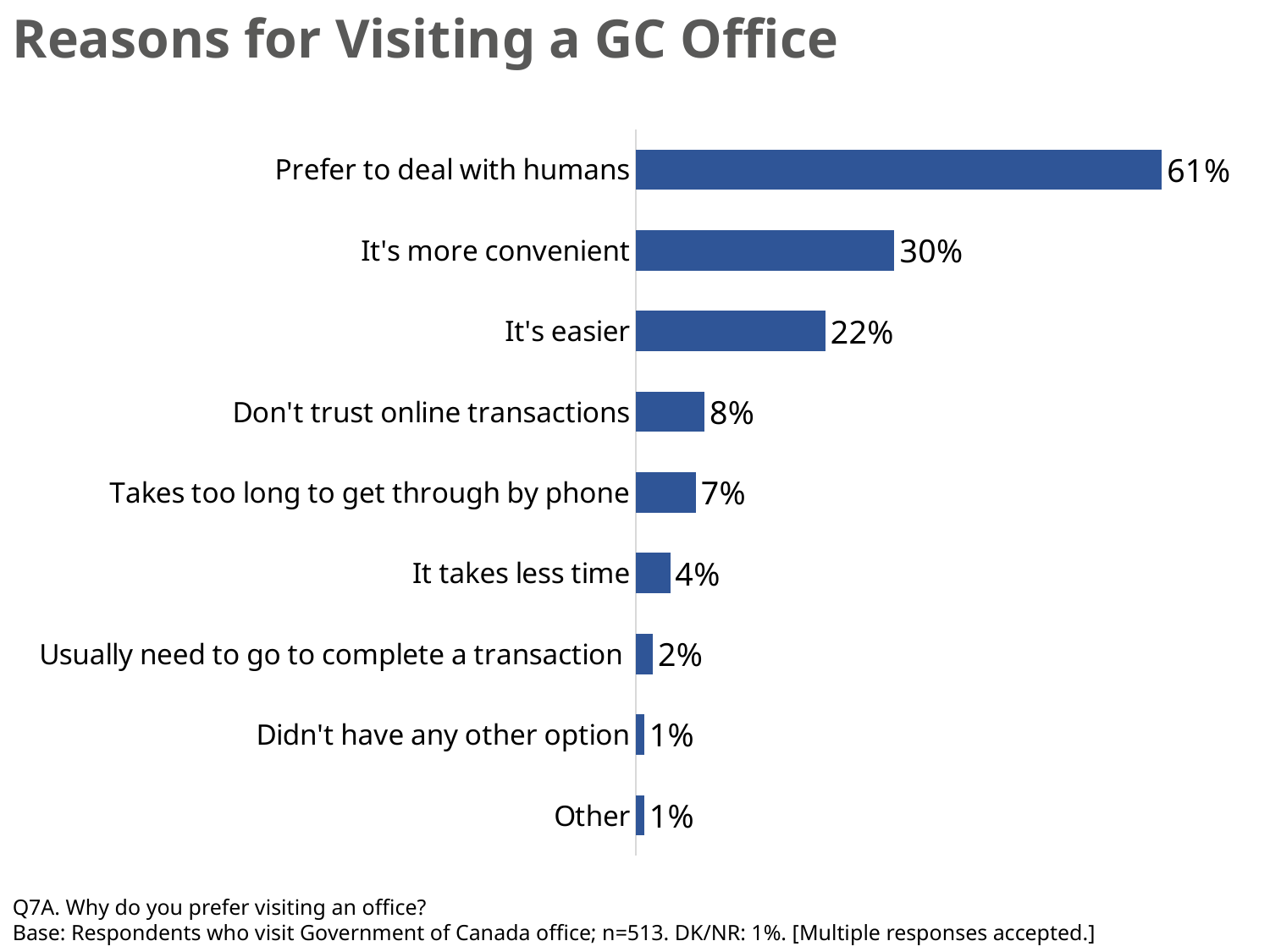
Which reason has the highest percentage? Prefer to deal with humans What is the value for "Usually need to go to complete a transaction"? 2% What kind of chart is shown on the slide? Bar chart What percentage of respondents said "Don't trust online transactions"? 8% Which is larger: "Don't trust online transactions" or "Takes too long to get through by phone"? Don't trust online transactions What is the value for "It's more convenient"? 30% What percentage of respondents said they prefer to deal with humans? 61% What is the difference between "It's more convenient" and "It's easier"? 8% What is the difference between "Prefer to deal with humans" and "It's more convenient"? 31% What is the value for "It takes less time"? 4% What is the title of the chart? Reasons for Visiting a GC Office How many reasons are shown in the chart? 9